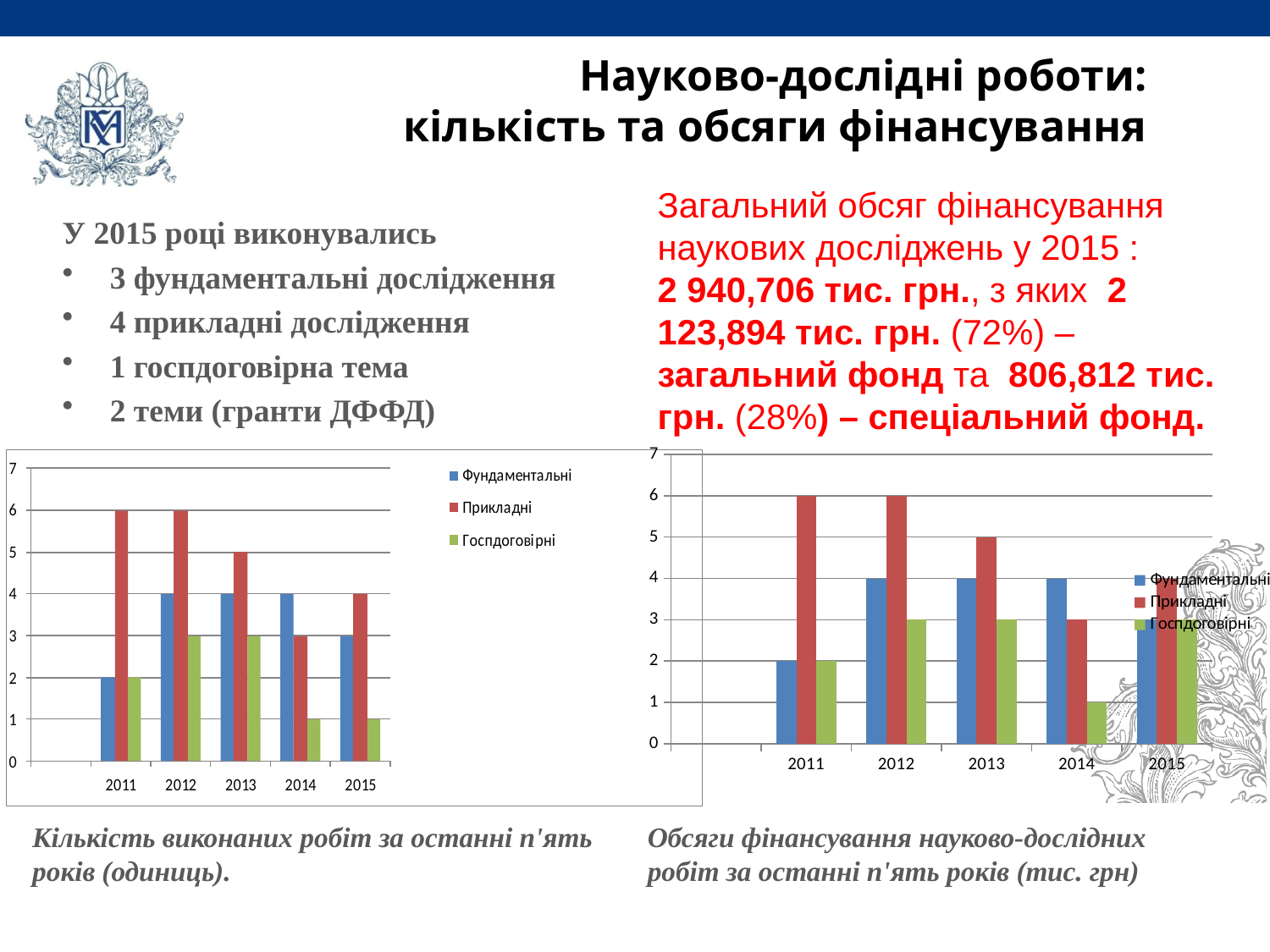
In the left chart, what is the value for Фундаментальні in 2011? 2 In the left chart, what is the value for Фундаментальні in 2015? 3 How many years are shown on the x axis of the left chart? 5 What kind of chart is the left chart (Кількість виконаних робіт за останні п'ять років)? bar chart In the left chart, do the values for Прикладні rise or fall from 2012 to 2014? fall How many series does the legend of the left chart list? 3 In the left chart, which series has the highest value in 2011? Прикладні In the left chart, what is the difference between Прикладні and Фундаментальні in 2011? 4 In the right chart (Обсяги фінансування науково-дослідних робіт), is the value for Фундаментальні in 2011 greater or less than 3? less In the left chart, which is larger in 2014: Фундаментальні or Госпдоговірні? Фундаментальні In the left chart, what is the value for Прикладні in 2011? 6 In the left chart, what colour represents the Госпдоговірні series? green